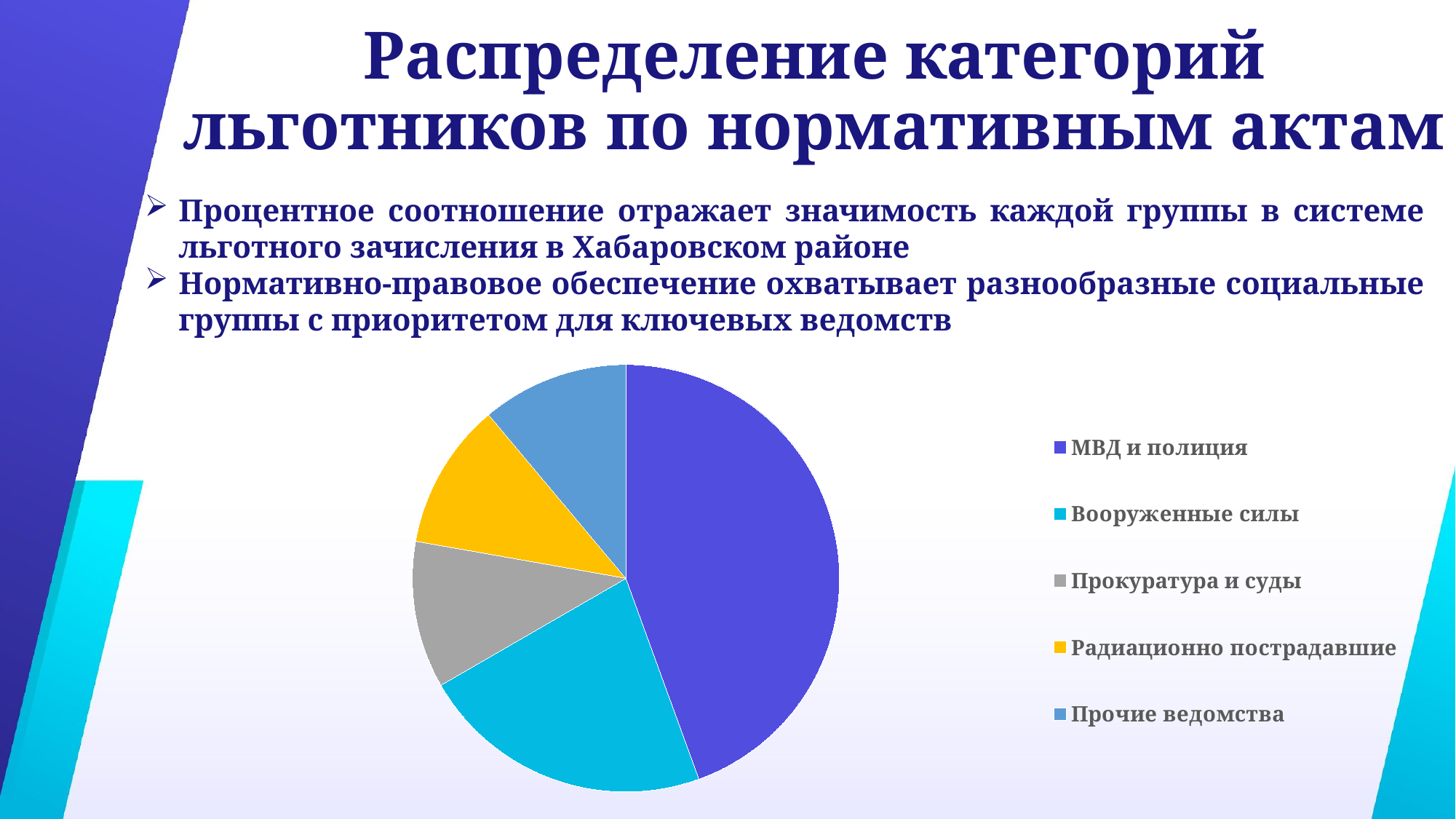
What is the title of the slide containing the pie chart? Распределение категорий льготников по нормативным актам Which slice is larger: МВД и полиция or Радиационно пострадавшие? МВД и полиция How many categories does the pie chart have? 5 Which slice is larger: Вооруженные силы or Прокуратура и суды? Вооруженные силы Which category is shown in yellow in the pie chart? Радиационно пострадавшие What kind of chart is shown on the slide? Pie chart Which slice is larger: Вооруженные силы or Прочие ведомства? Вооруженные силы Which category is the second largest slice of the pie chart? Вооруженные силы Which category has the largest slice of the pie chart? МВД и полиция